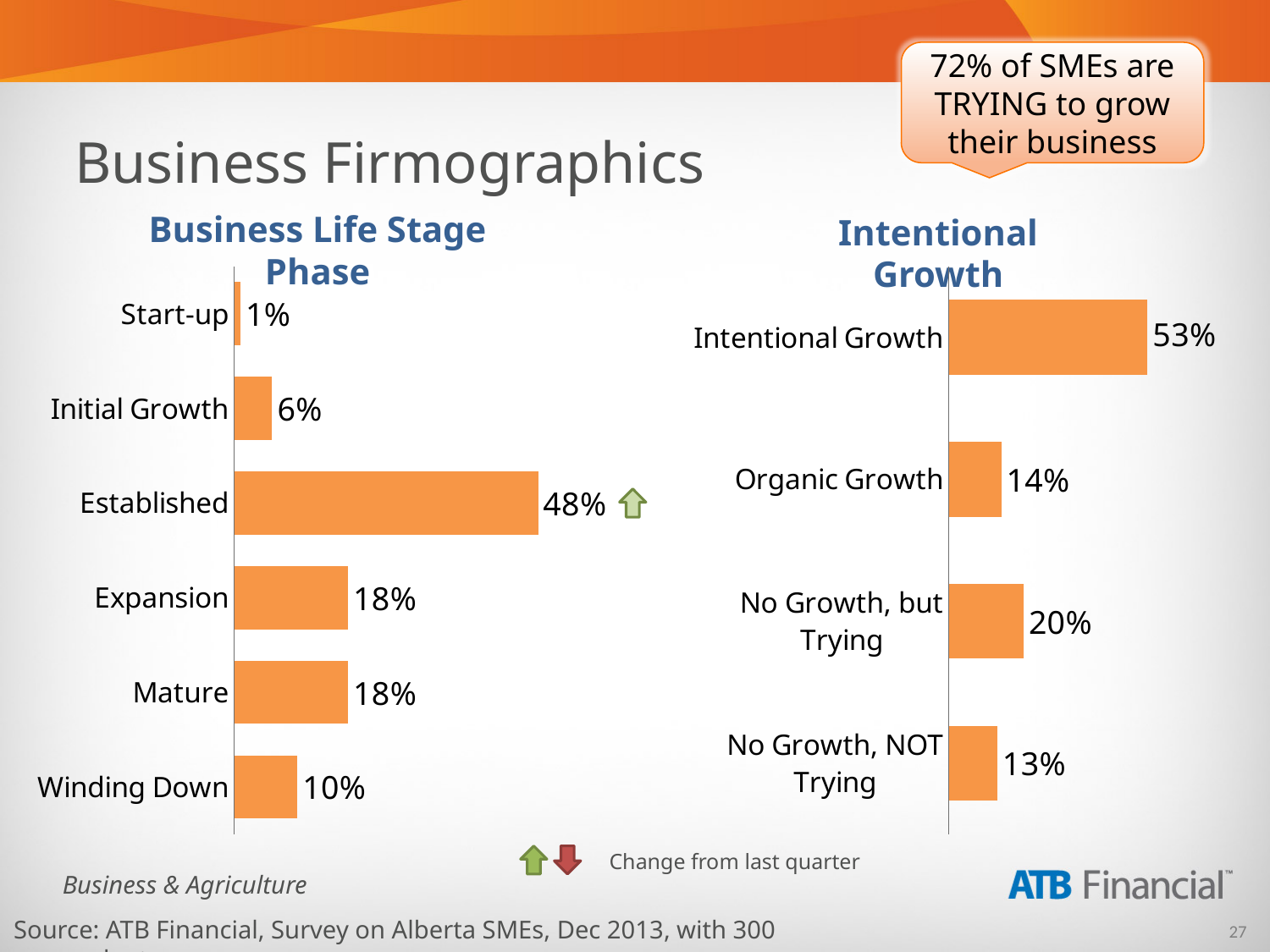
In the Business Life Stage Phase chart, what is the value for Winding Down? 10% In the Intentional Growth chart, which category has the highest value? Intentional Growth In the Intentional Growth chart, how many categories are shown? 4 In the Business Life Stage Phase chart, what is the difference between Established and Expansion? 30% In the Business Life Stage Phase chart, which is larger, Initial Growth or Winding Down? Winding Down In the Business Life Stage Phase chart, how many categories are shown? 6 In the Business Life Stage Phase chart, what is the value for Established? 48% In the Intentional Growth chart, what is the value for Organic Growth? 14% In the Business Life Stage Phase chart, which category has a green up arrow next to its value? Established In the Intentional Growth chart, what is the difference between No Growth, but Trying and No Growth, NOT Trying? 7% In the Business Life Stage Phase chart, which category has the lowest value? Start-up What type of chart is the Intentional Growth chart? Bar chart